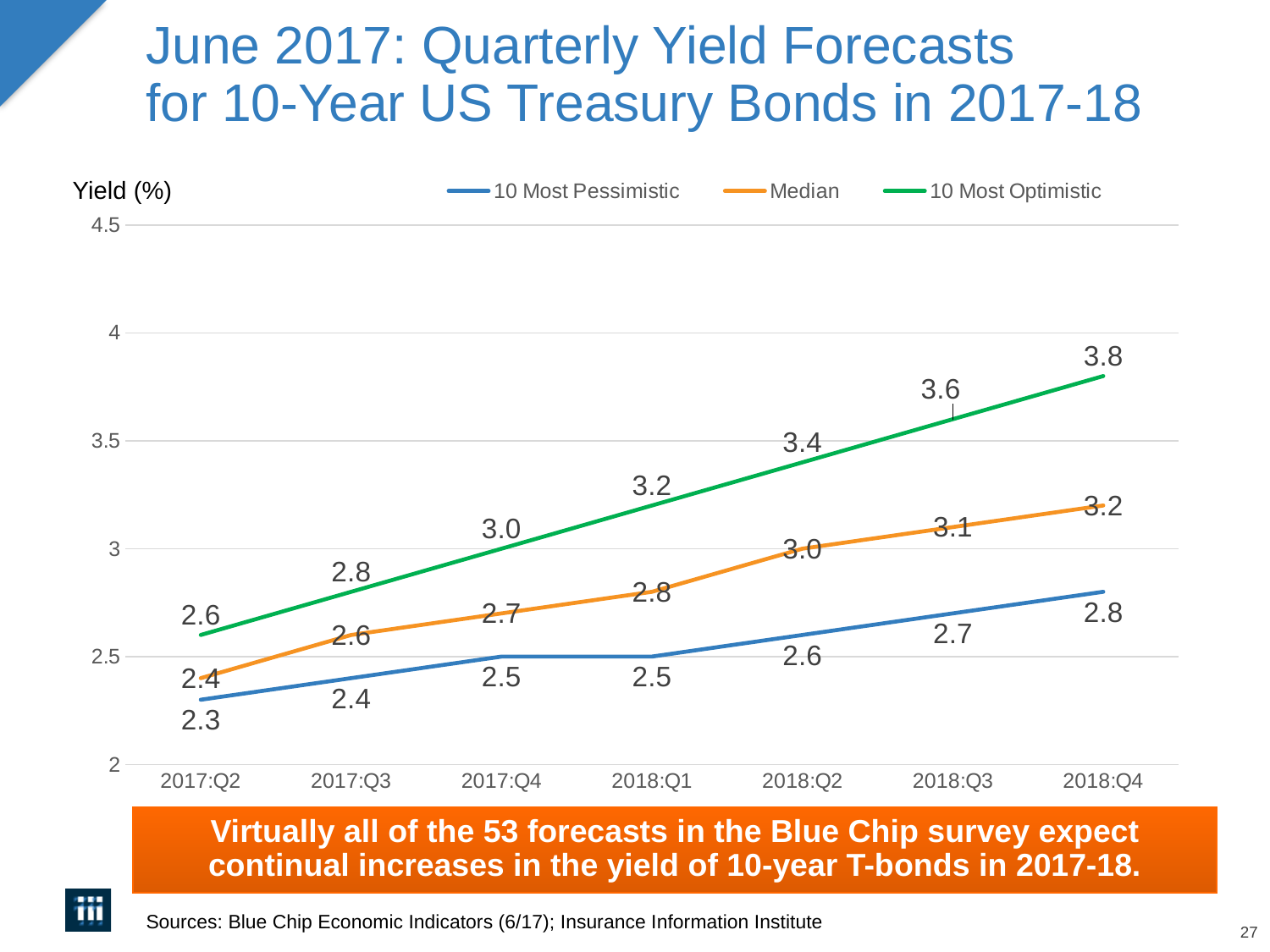
Does the 10 Most Optimistic forecast rise or fall from 2017:Q2 to 2018:Q4? Rise What colour is the line for the Median series? Orange What is the difference between the 10 Most Optimistic and 10 Most Pessimistic forecasts for 2018:Q4? 1.0 Which is larger in 2018:Q3, the Median forecast or the 10 Most Pessimistic forecast? Median What is the 10 Most Pessimistic forecast for 2017:Q2? 2.3 What type of chart is shown on the slide? Line chart In which quarter is the Median forecast highest? 2018:Q4 What is the Median forecast for 2018:Q2? 3.0 How many quarters are plotted along the x axis? 7 How many series does the legend list? 3 What is the 10 Most Optimistic forecast for 2018:Q4? 3.8 In which quarter is the 10 Most Optimistic forecast lowest? 2017:Q2